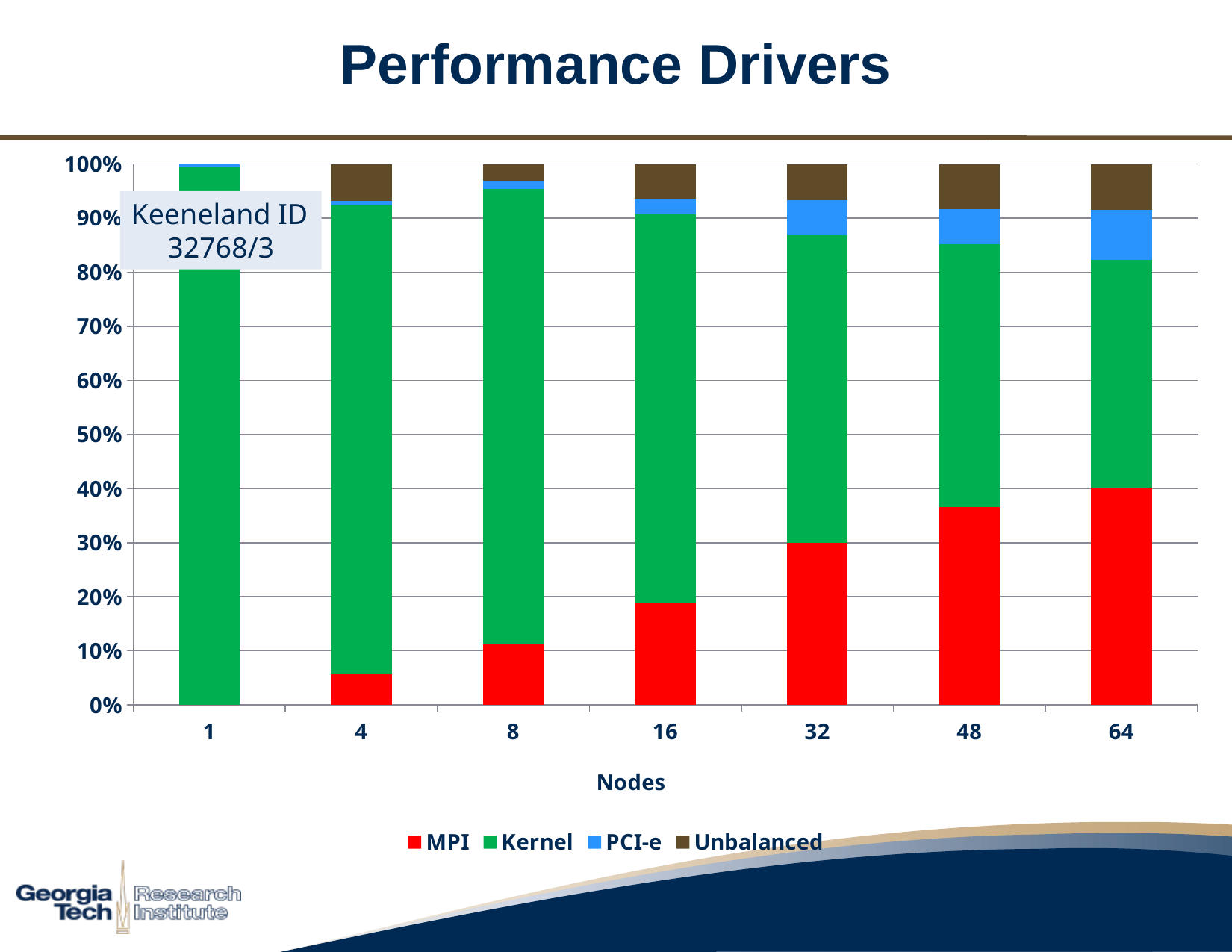
Is the MPI share for 4 nodes greater or less than 10%? less What kind of chart is shown on the slide? Stacked bar chart Which has the larger MPI share, 48 nodes or 64 nodes? 64 nodes Which node count has the largest Kernel share? 1 Is the MPI share for 64 nodes greater or less than 30%? greater Which node count has the largest MPI share? 64 How many series does the legend list? 4 How many node counts (categories) are plotted along the x axis? 7 What is the title of the x axis? Nodes Which series are listed in the legend? MPI, Kernel, PCI-e, Unbalanced Does the MPI share rise or fall as the number of nodes increases along the x axis? Rises What is the total of the stacked bar for 64 nodes? 100%